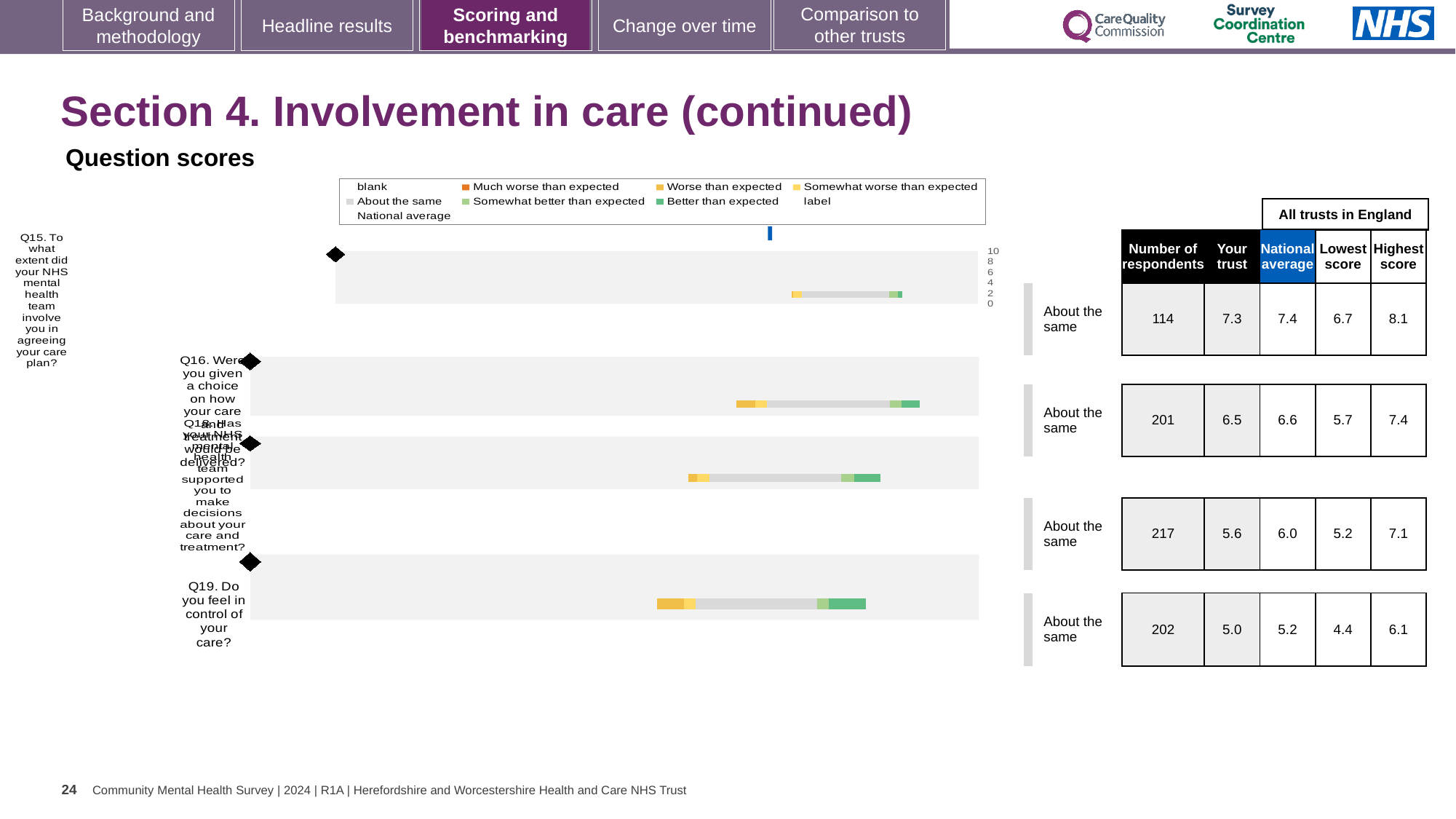
What benchmark category is shown for Q19 (feeling in control of your care)? About the same How many questions are plotted in the question scores chart? 4 What is the 'Your trust' score for Q15 (involvement in agreeing your care plan)? 7.3 For Q16, which is larger: the 'Your trust' score or the national average? National average What kind of chart is used to show the question scores on this slide? bar chart Which question has the lowest 'Your trust' score? Q19 What is the lowest score among all trusts in England for Q15? 6.7 What is the difference between the national average and the 'Your trust' score for Q18? 0.4 What is the national average score for Q18 (supported to make decisions about care and treatment)? 6.0 How many respondents answered Q16 (choice on how care and treatment would be delivered)? 201 Which question has the highest 'Your trust' score? Q15 What is the highest score among all trusts in England for Q19 (feeling in control of your care)? 6.1